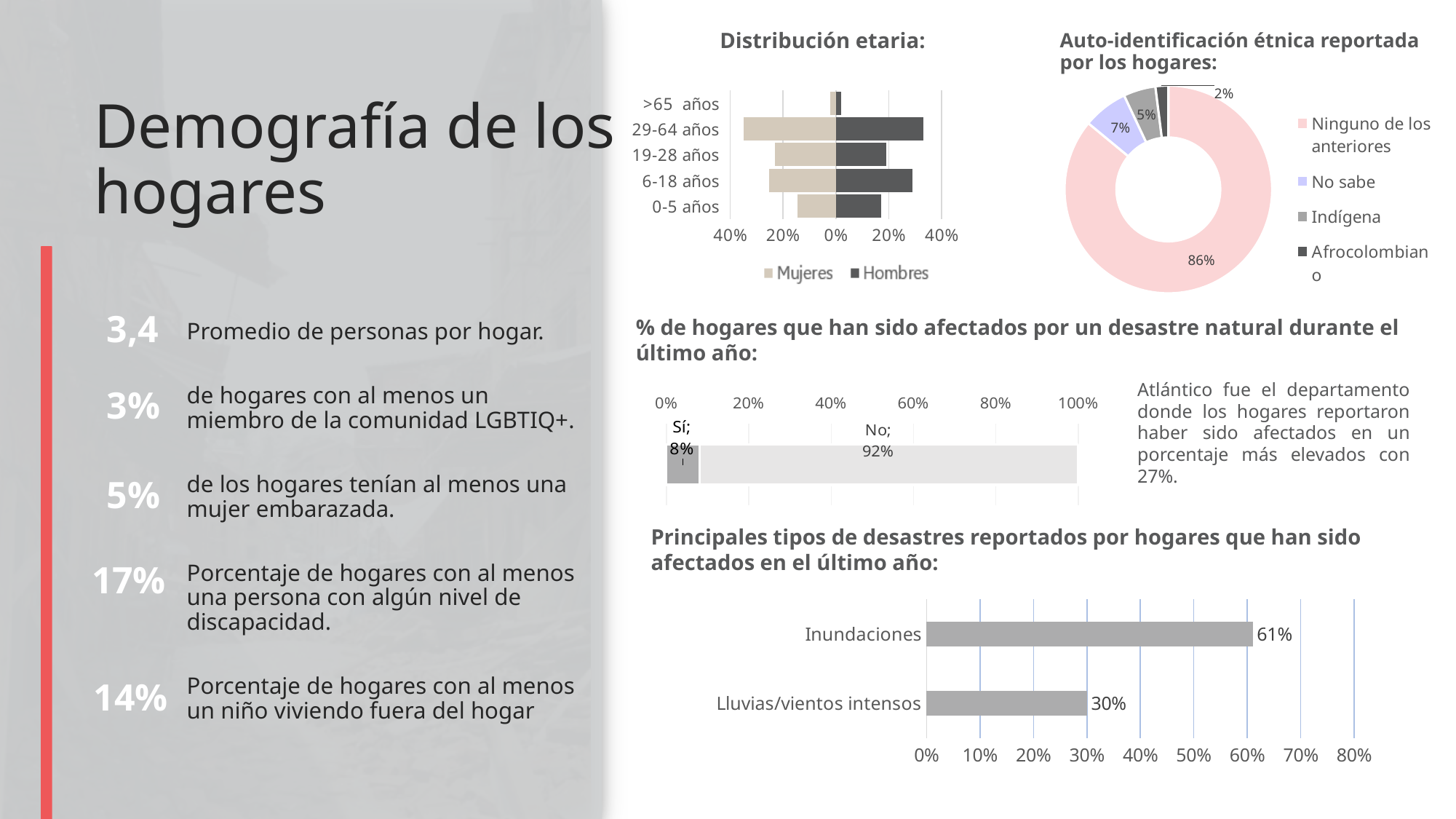
In the 'Distribución etaria' chart, is the value for Hombres in the 29-64 años group greater or less than 20%? greater In the 'Principales tipos de desastres reportados' chart, what is the value for Lluvias/vientos intensos? 30% In the 'Auto-identificación étnica reportada por los hogares' chart, which category has the smallest share? Afrocolombiano In the 'Auto-identificación étnica reportada por los hogares' chart, what share is 'Ninguno de los anteriores'? 86% In the 'Principales tipos de desastres reportados' chart, what is the difference between Inundaciones and Lluvias/vientos intensos? 31% In the 'Auto-identificación étnica reportada por los hogares' chart, how many categories does the legend list? 4 In the '% de hogares que han sido afectados por un desastre natural' chart, what is the value for 'Sí'? 8% In the 'Auto-identificación étnica reportada por los hogares' chart, what share is 'No sabe'? 7% In the 'Principales tipos de desastres reportados' chart, how many categories are shown? 2 In the 'Distribución etaria' chart, how many series does the legend list? 2 In the 'Principales tipos de desastres reportados' chart, what is the value for Inundaciones? 61% In the '% de hogares que han sido afectados por un desastre natural' chart, which is larger, 'Sí' or 'No'? No